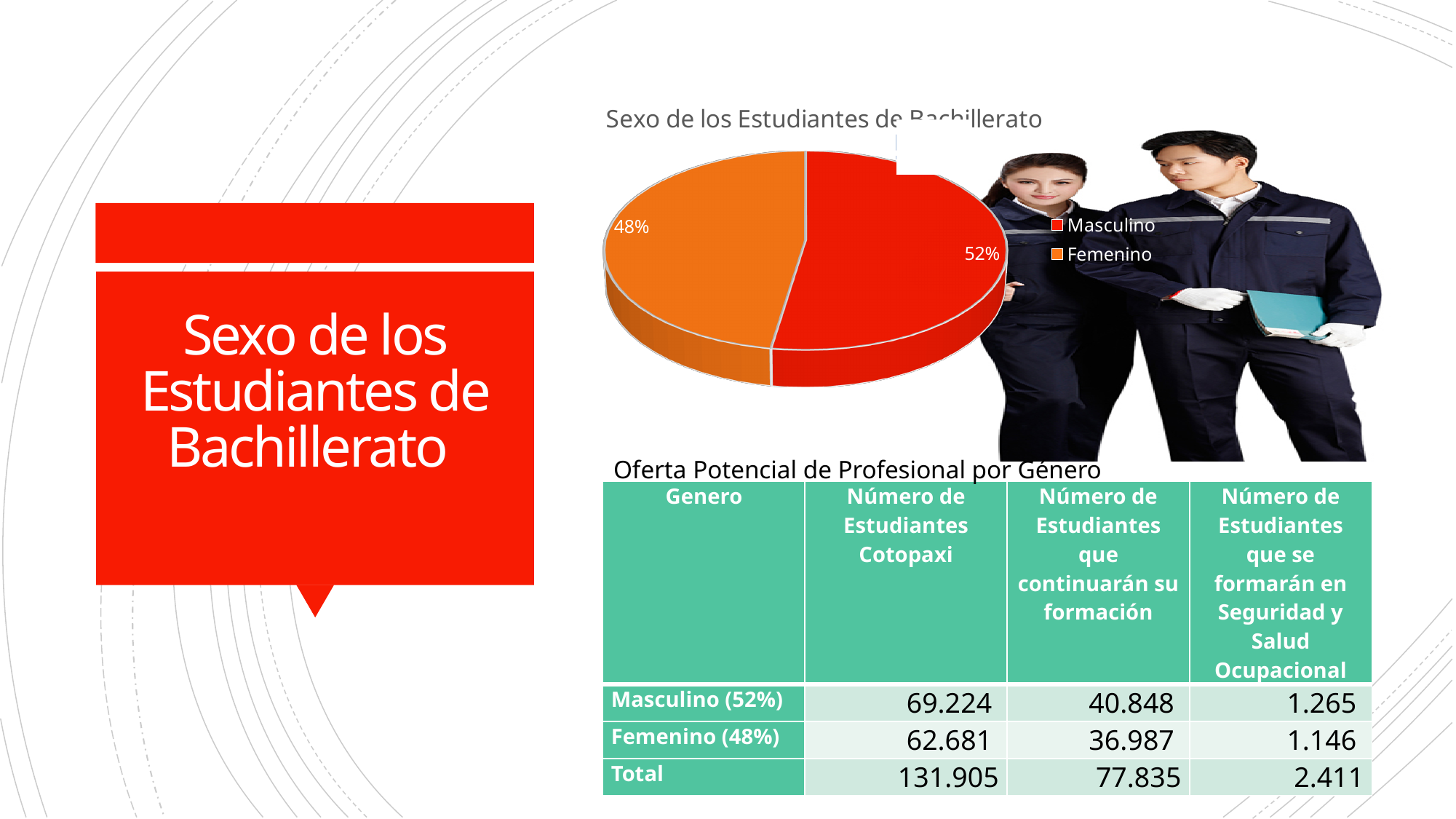
Which category has the smallest slice in the pie chart? Femenino What kind of chart is shown on the slide? pie chart What share of the pie does Masculino represent? 52% How many slices does the pie chart have? 2 What is the title of the pie chart? Sexo de los Estudiantes de Bachillerato How many entries does the legend of the pie chart list? 2 What is the difference in percentage points between the Masculino and Femenino slices? 4% What share of the pie does Femenino represent? 48% Which category has the largest slice in the pie chart? Masculino Which slice is larger, Masculino or Femenino? Masculino What colour is the Femenino slice in the pie chart? orange